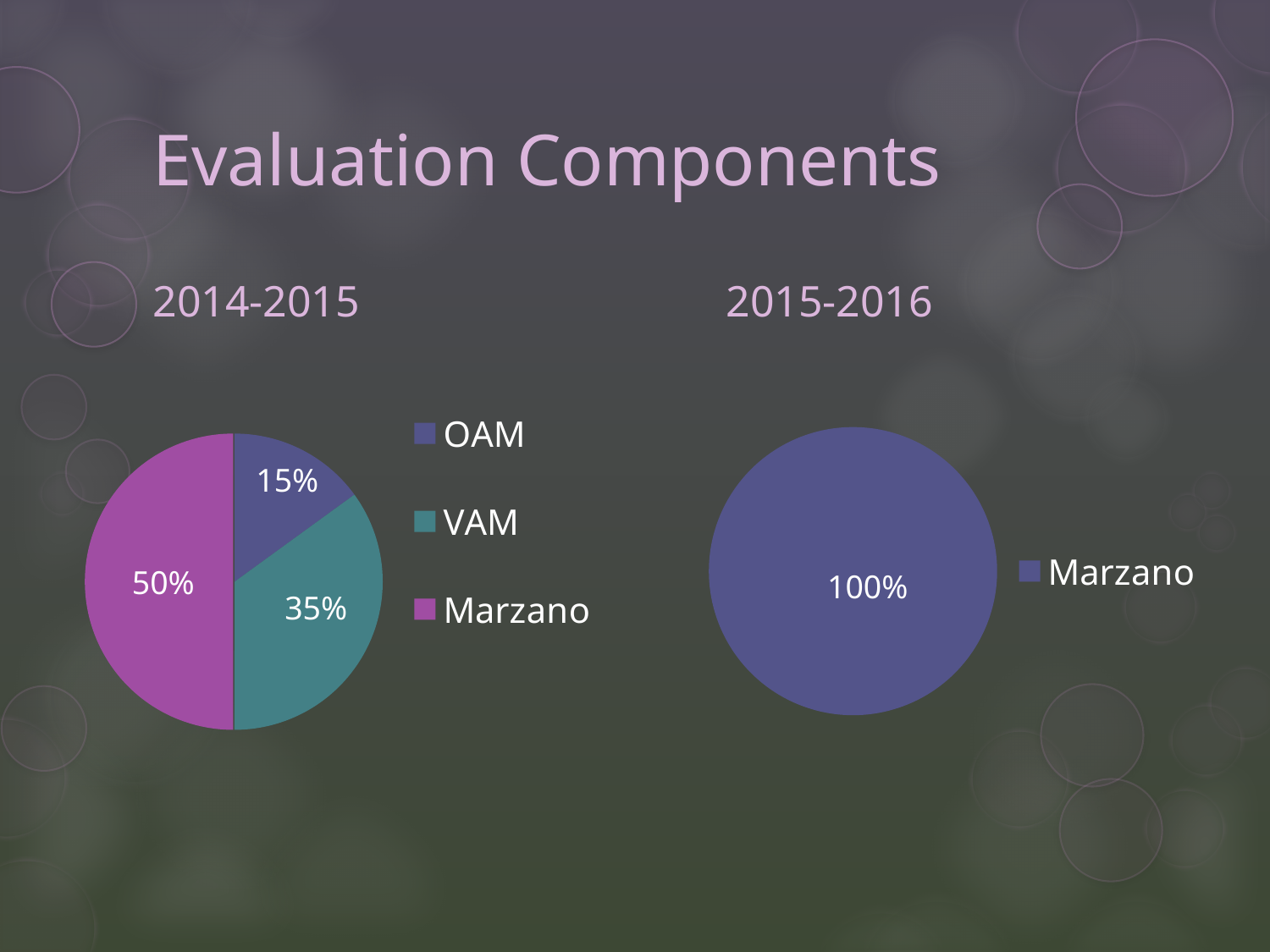
In the 2014-2015 chart, what share does OAM have? 15% What kind of chart is the 2015-2016 chart? Pie chart In the 2014-2015 chart, which component has the largest share? Marzano In the 2015-2016 chart, what share does Marzano have? 100% How many slices does the 2014-2015 pie chart have? 3 In the 2014-2015 chart, what is the difference between the Marzano share and the VAM share? 15% In the 2014-2015 chart, what share does VAM have? 35% In the 2014-2015 chart, which component has the smallest share? OAM In the 2014-2015 chart, what share does Marzano have? 50% In the 2014-2015 chart, which is larger, VAM or OAM? VAM How many entries does the legend of the 2015-2016 chart list? 1 In the 2014-2015 chart, what colour is the Marzano slice? Purple